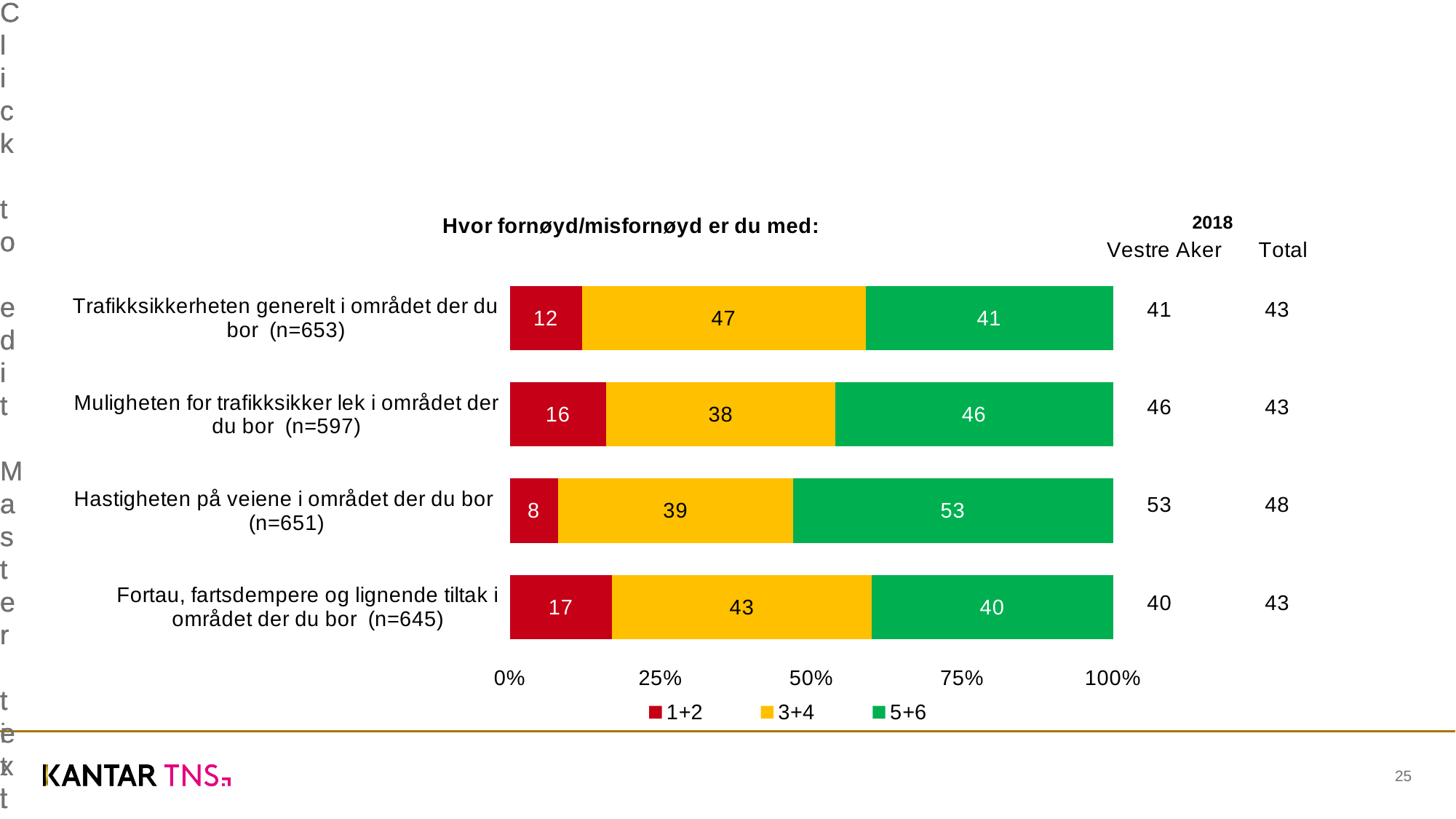
Which is larger: the 3+4 value for 'Trafikksikkerheten generelt i området der du bor (n=653)' or the 3+4 value for 'Muligheten for trafikksikker lek i området der du bor (n=597)'? Trafikksikkerheten generelt i området der du bor (n=653) What is the title of the chart? Hvor fornøyd/misfornøyd er du med: What is the value of the 3+4 series for 'Trafikksikkerheten generelt i området der du bor (n=653)'? 47 Which category has the lowest value for the 1+2 series? Hastigheten på veiene i området der du bor (n=651) How many categories are shown in the chart? 4 What is the total of the stacked bar for 'Muligheten for trafikksikker lek i området der du bor (n=597)'? 100 What is the difference between the 5+6 values for 'Muligheten for trafikksikker lek i området der du bor (n=597)' and 'Fortau, fartsdempere og lignende tiltak i området der du bor (n=645)'? 6 What is the value of the 1+2 series for 'Fortau, fartsdempere og lignende tiltak i området der du bor (n=645)'? 17 What is the value of the 5+6 series for 'Hastigheten på veiene i området der du bor (n=651)'? 53 How many series does the legend list? 3 Which category has the highest value for the 5+6 series? Hastigheten på veiene i området der du bor (n=651) What kind of chart is shown on the slide? Stacked bar chart